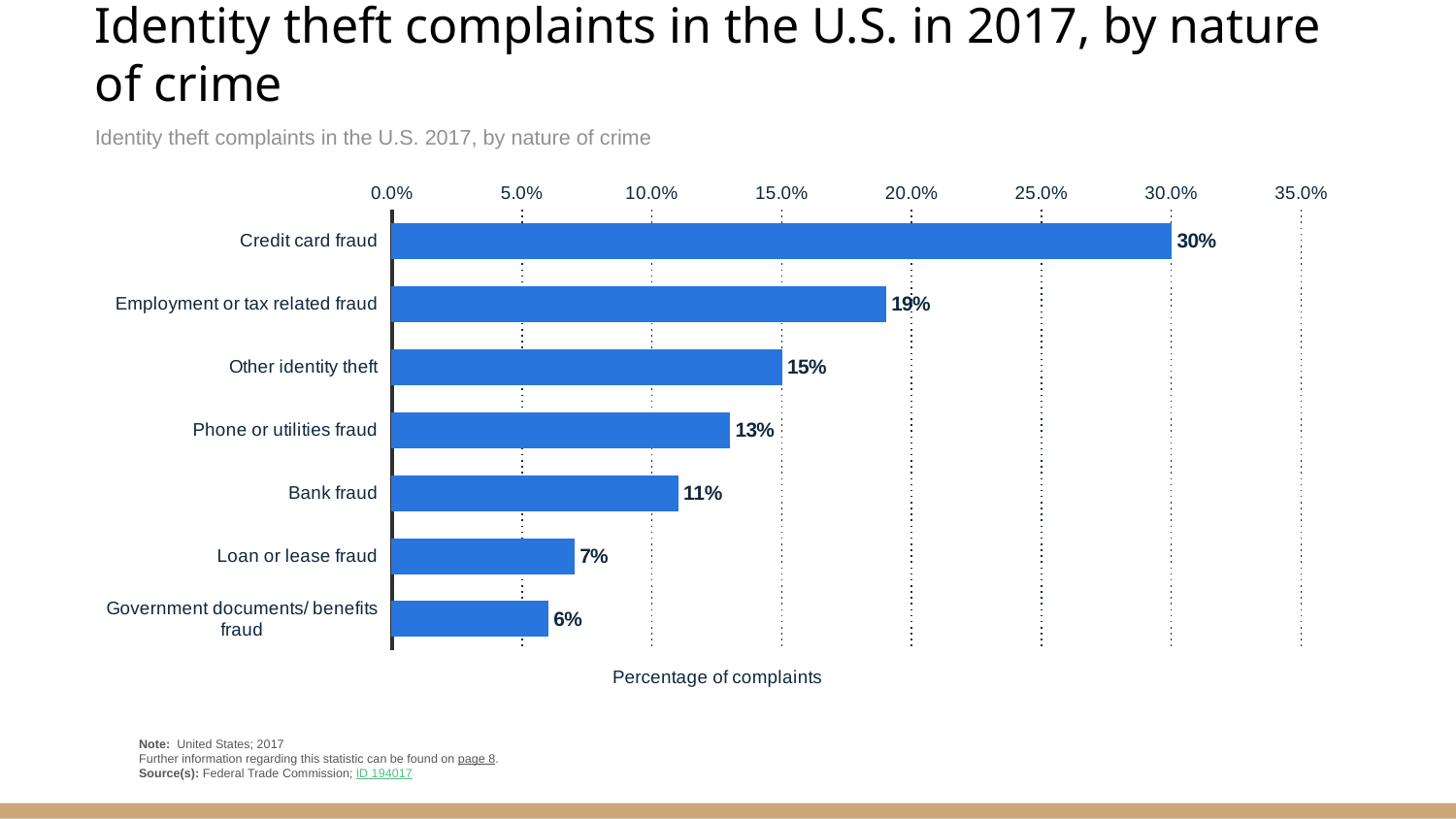
What type of chart is shown on the slide? Bar chart What percentage of complaints does the chart show for bank fraud? 11% What percentage of identity theft complaints were for credit card fraud? 30% Is the value for loan or lease fraud greater or less than 10.0%? less Which has a larger share of complaints, other identity theft or bank fraud? Other identity theft How many categories of crime are shown in the chart? 7 Which nature of crime has the highest percentage of complaints? Credit card fraud What is the label of the horizontal axis? Percentage of complaints Which nature of crime has the lowest percentage of complaints? Government documents/ benefits fraud What is the difference between the values for phone or utilities fraud and loan or lease fraud? 6 What is the value shown for employment or tax related fraud? 19% What is the difference in percentage points between credit card fraud and employment or tax related fraud? 11